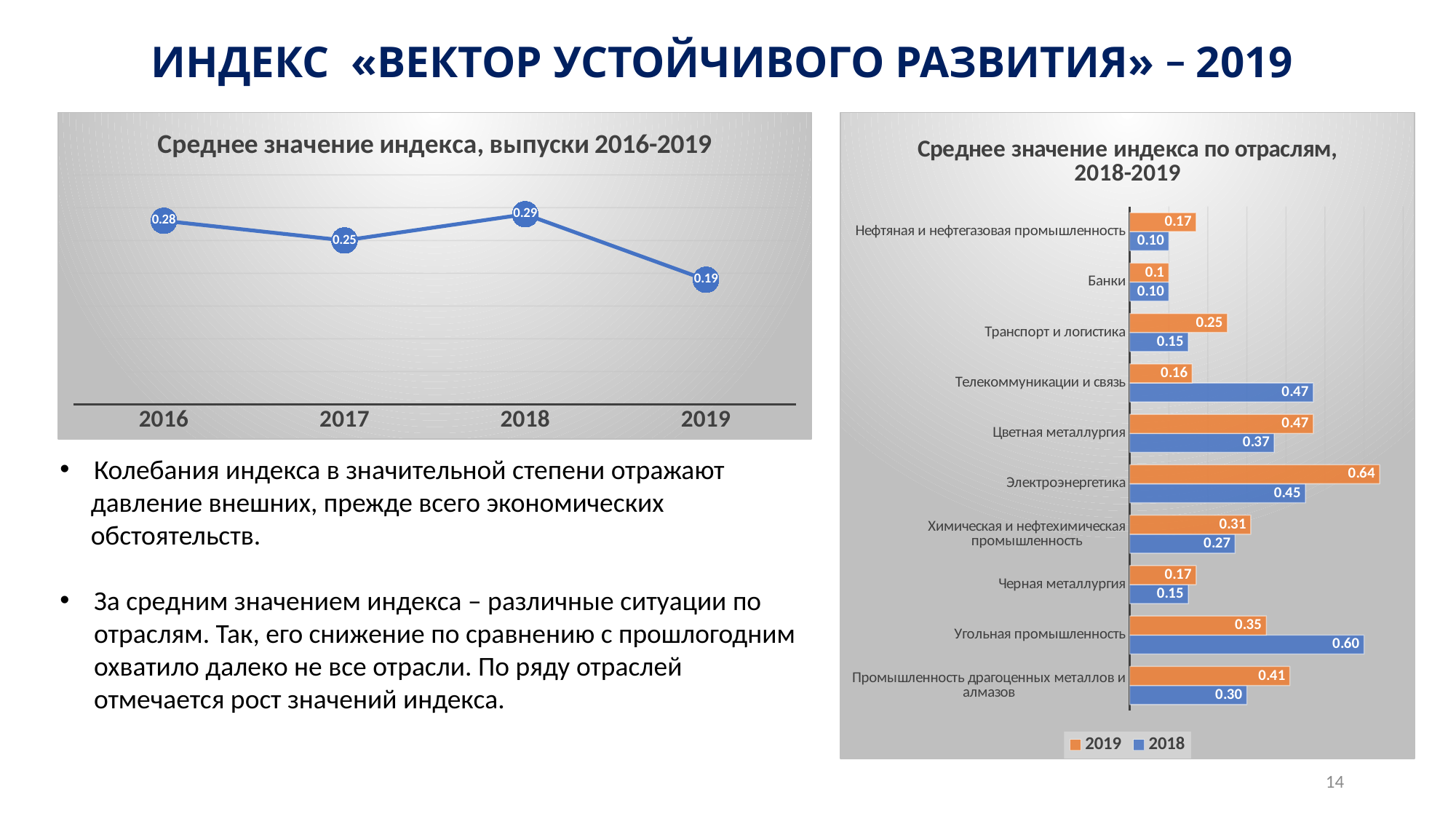
In the chart 'Среднее значение индекса по отраслям, 2018-2019', what is the 2019 value for Электроэнергетика? 0.64 In the chart 'Среднее значение индекса, выпуски 2016-2019', what is the value for 2018? 0.29 In the chart 'Среднее значение индекса, выпуски 2016-2019', what is the difference between the 2018 and 2019 values? 0.10 In the chart 'Среднее значение индекса по отраслям, 2018-2019', what is the 2018 value for Угольная промышленность? 0.60 In the chart 'Среднее значение индекса по отраслям, 2018-2019', which colour represents 2019? Orange How many series does the legend of the chart 'Среднее значение индекса по отраслям, 2018-2019' list? 2 In the chart 'Среднее значение индекса по отраслям, 2018-2019', what is the difference between the 2019 and 2018 values for Цветная металлургия? 0.10 In the chart 'Среднее значение индекса по отраслям, 2018-2019', which is larger for Телекоммуникации и связь: the 2019 value or the 2018 value? 2018 In the chart 'Среднее значение индекса, выпуски 2016-2019', which year has the lowest value? 2019 In the chart 'Среднее значение индекса, выпуски 2016-2019', how many data points are plotted? 4 In the chart 'Среднее значение индекса по отраслям, 2018-2019', which industry has the highest 2019 value? Электроэнергетика What kind of chart is 'Среднее значение индекса, выпуски 2016-2019'? Line chart